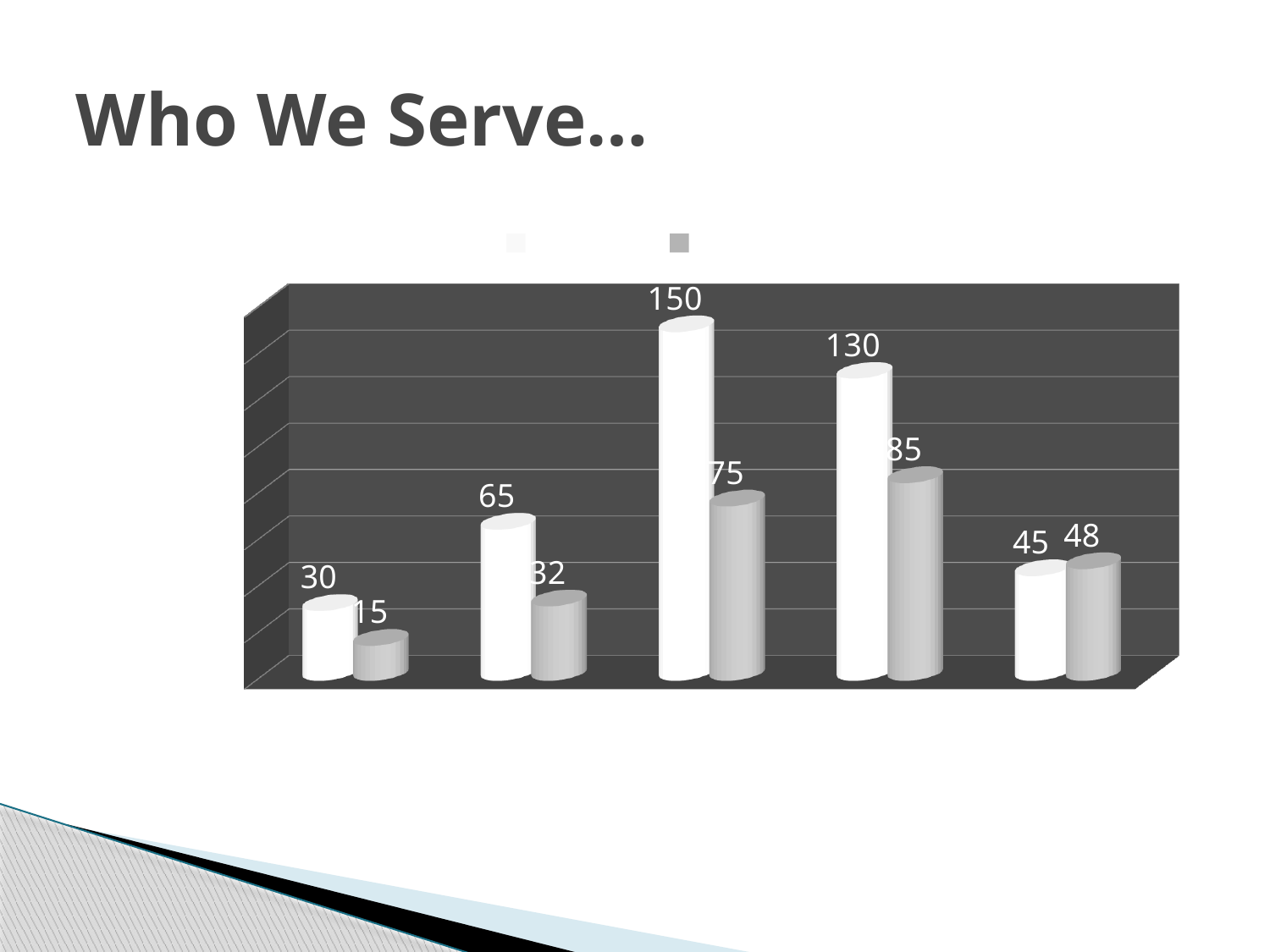
Which group has the lowest gray bar? the first group from the left (15) What is the value of the white bar in the third group from the left? 150 What is the difference between the white bars of the third and fourth groups from the left? 20 What is the value of the gray bar in the fourth group from the left? 85 What is the value of the gray bar in the first group from the left? 15 In the second group from the left, which bar is larger, the white bar or the gray bar? the white bar How many groups of bars are plotted in the chart? 5 How many series does the chart's legend list? 2 What is the difference between the white and gray bars in the third group from the left? 75 What kind of chart is shown on the slide? bar chart Which group has the highest white bar? the third group from the left (150) What is the value of the white bar in the first group from the left? 30